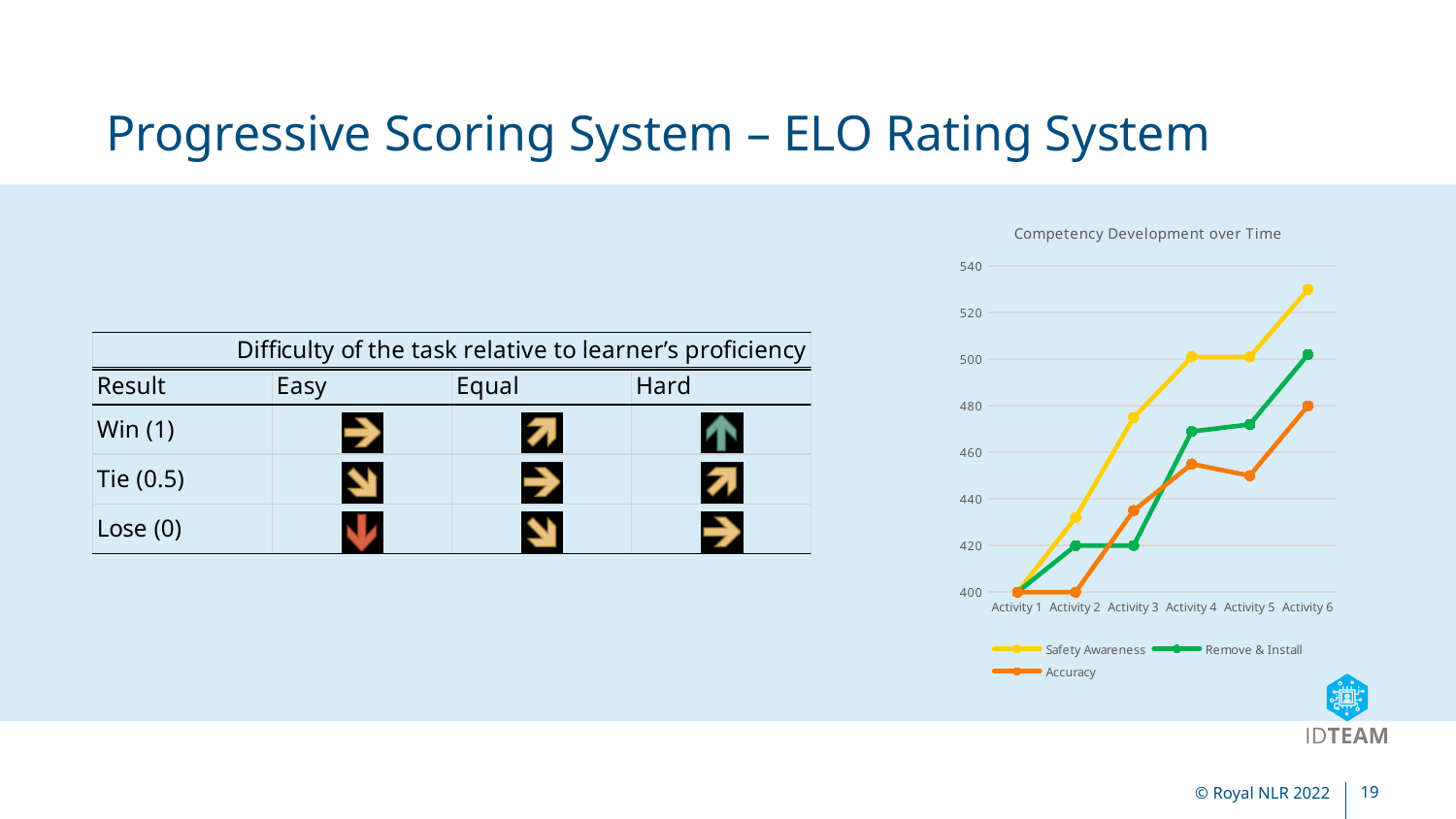
Is the value for Safety Awareness at Activity 6 greater or less than 520? greater Does the Safety Awareness series generally rise or fall from Activity 1 to Activity 6? rise Which series has the highest value at Activity 6? Safety Awareness What is the value of Safety Awareness at Activity 1? 400 How many series does the chart's legend list? 3 Which series has the lowest value at Activity 6? Accuracy What is the title of the chart on the slide? Competency Development over Time Is the value for Accuracy at Activity 4 greater or less than 440? greater What type of chart is shown on the slide? line chart How many activities are shown along the x axis of the chart? 6 At Activity 3, which is larger: Safety Awareness or Remove & Install? Safety Awareness What is the value of Accuracy at Activity 2? 400